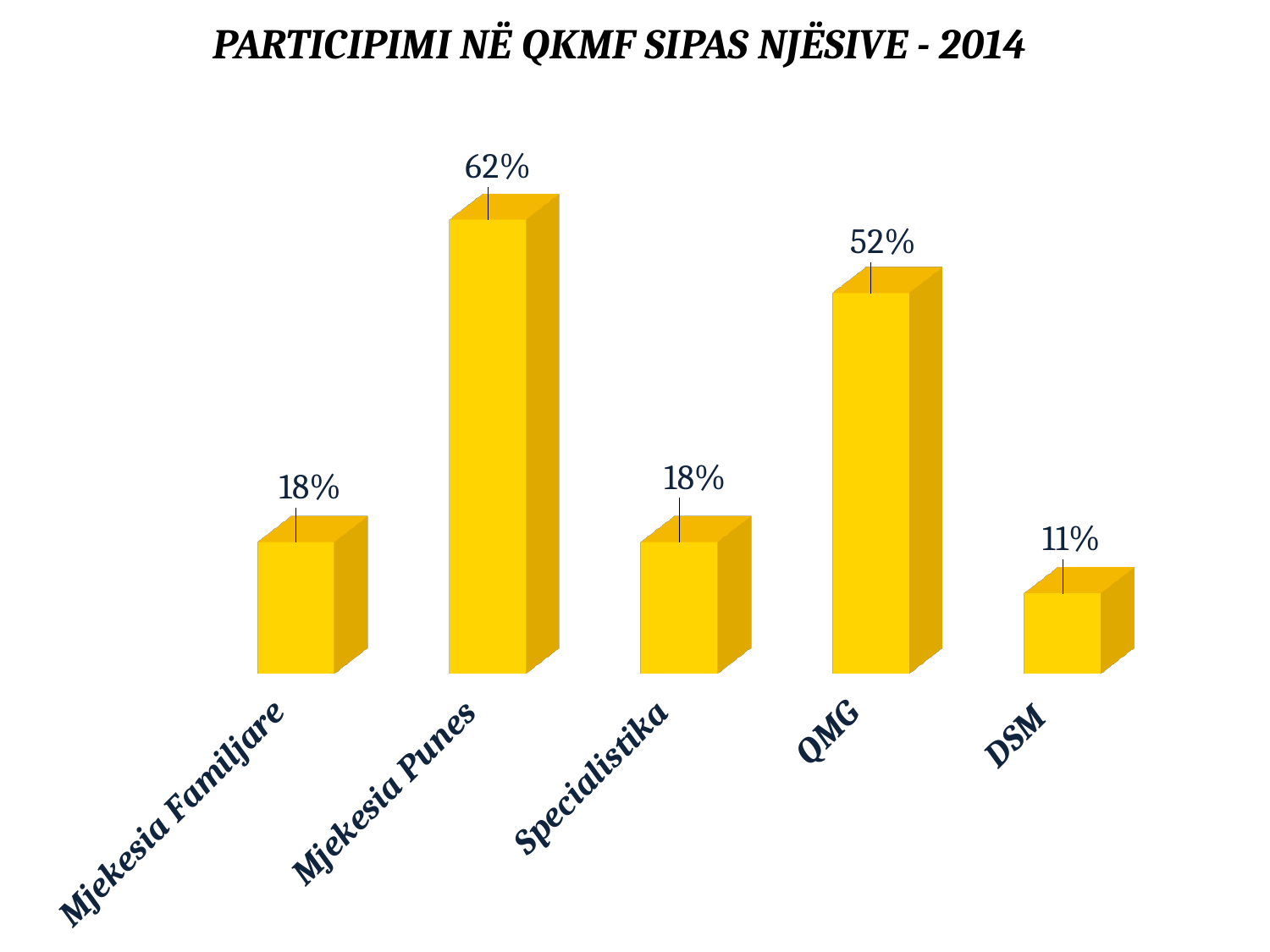
What is the title of the chart? PARTICIPIMI NË QKMF SIPAS NJËSIVE - 2014 What is the value for Mjekesia Punes? 62% What kind of chart is this? Bar chart Which category has the highest value? Mjekesia Punes What is the difference between the values for Mjekesia Punes and QMG? 10% What is the value for Specialistika? 18% What is the value for DSM? 11% What is the difference between the values for Mjekesia Familjare and DSM? 7% What is the value for QMG? 52% Which category has the lowest value? DSM How many categories are shown in the chart? 5 Which is larger, the value for QMG or the value for Specialistika? QMG